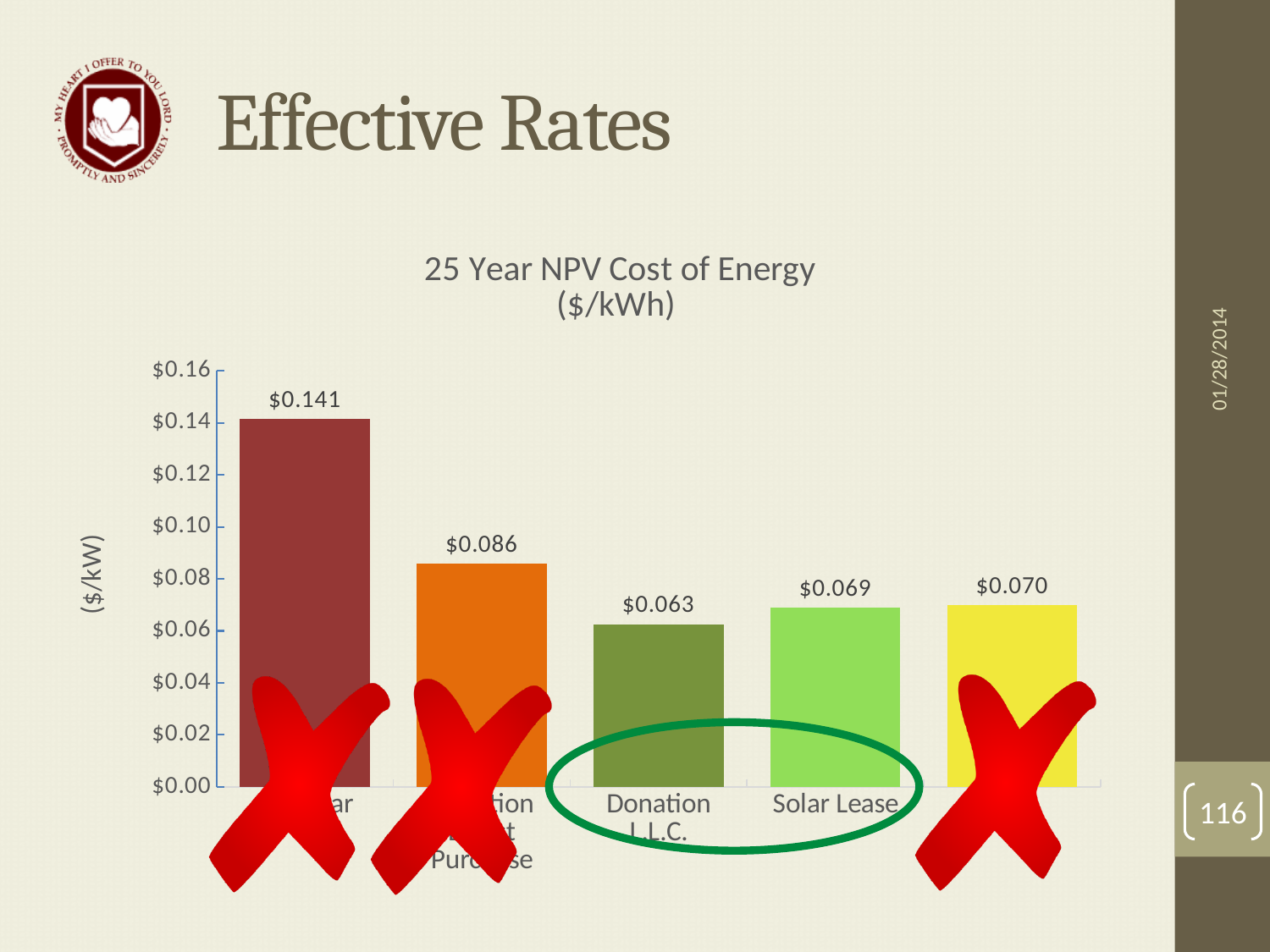
What kind of chart is shown on the slide? bar chart What is the value for Solar Lease? $0.069 How many bars are plotted in the chart? 5 Which is larger, the value for Donation L.L.C. or the value for Solar Lease? Solar Lease Which category has the lowest value in the chart? Donation L.L.C. What is the highest value shown on any bar in the chart? $0.141 What is the value for Donation L.L.C.? $0.063 What is the title of the chart? 25 Year NPV Cost of Energy ($/kWh) Is the value for Donation L.L.C. greater or less than $0.06? greater What is the difference between the values for Solar Lease and Donation L.L.C.? $0.006 Is the value for Solar Lease greater or less than $0.08? less What is the label on the vertical axis of the chart? ($/kW)